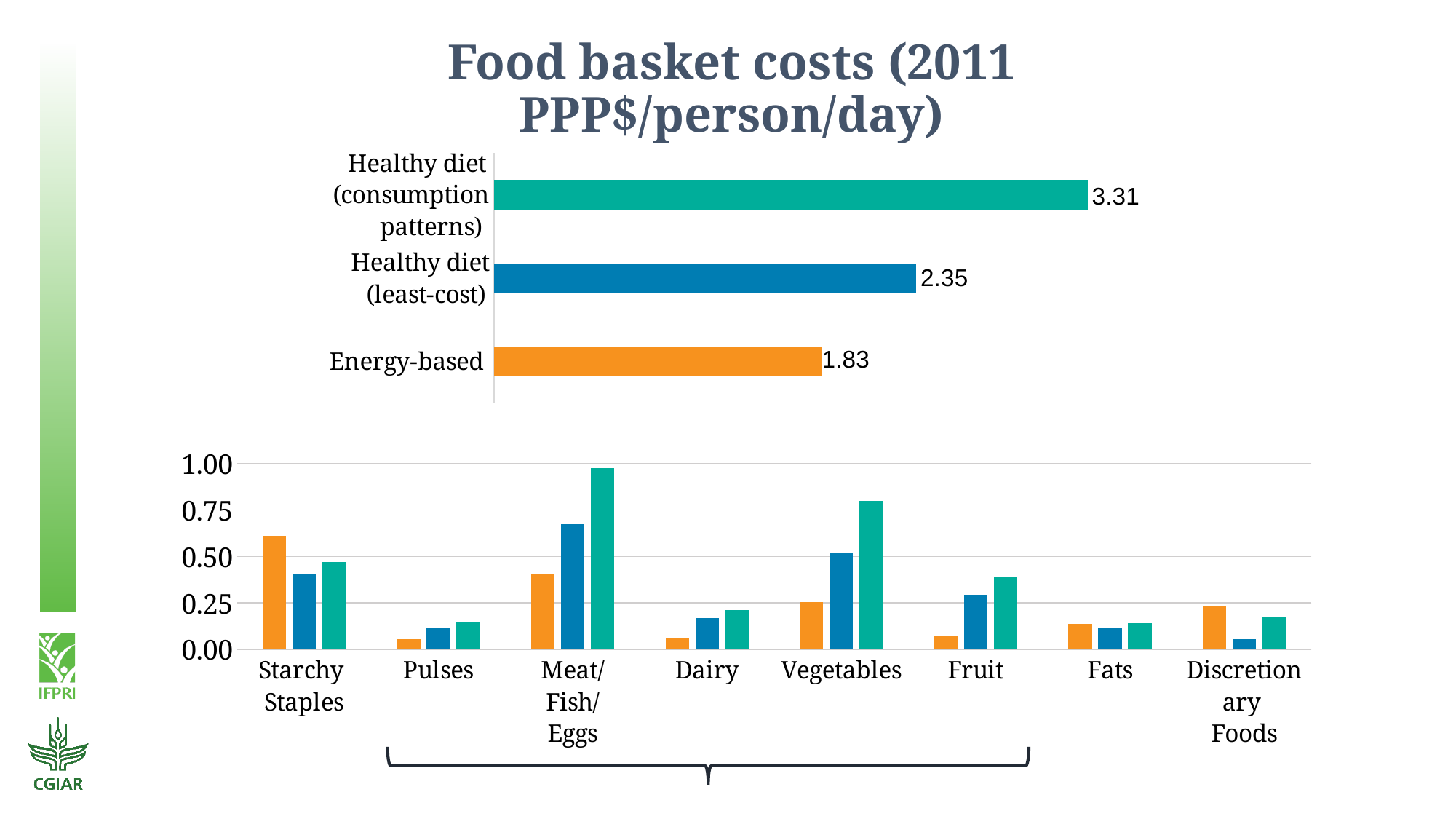
In the top horizontal bar chart, what is the value for Energy-based? 1.83 In the bottom chart, is the teal bar for Meat/Fish/Eggs greater or less than 0.75? greater In the top horizontal bar chart, what is the difference between Healthy diet (consumption patterns) and Energy-based? 1.48 What kind of chart is the bottom chart on the slide? Bar chart How many categories are shown in the top horizontal bar chart? 3 In the top horizontal bar chart, what is the value for Healthy diet (least-cost)? 2.35 In the top horizontal bar chart, what is the value for Healthy diet (consumption patterns)? 3.31 How many food categories are shown on the x axis of the bottom chart? 8 In the top horizontal bar chart, which category has the highest value? Healthy diet (consumption patterns) In the bottom chart, is the orange bar for Pulses greater or less than 0.25? less In the top horizontal bar chart, what is the difference between Healthy diet (least-cost) and Energy-based? 0.52 In the top horizontal bar chart, which category has the lowest value? Energy-based